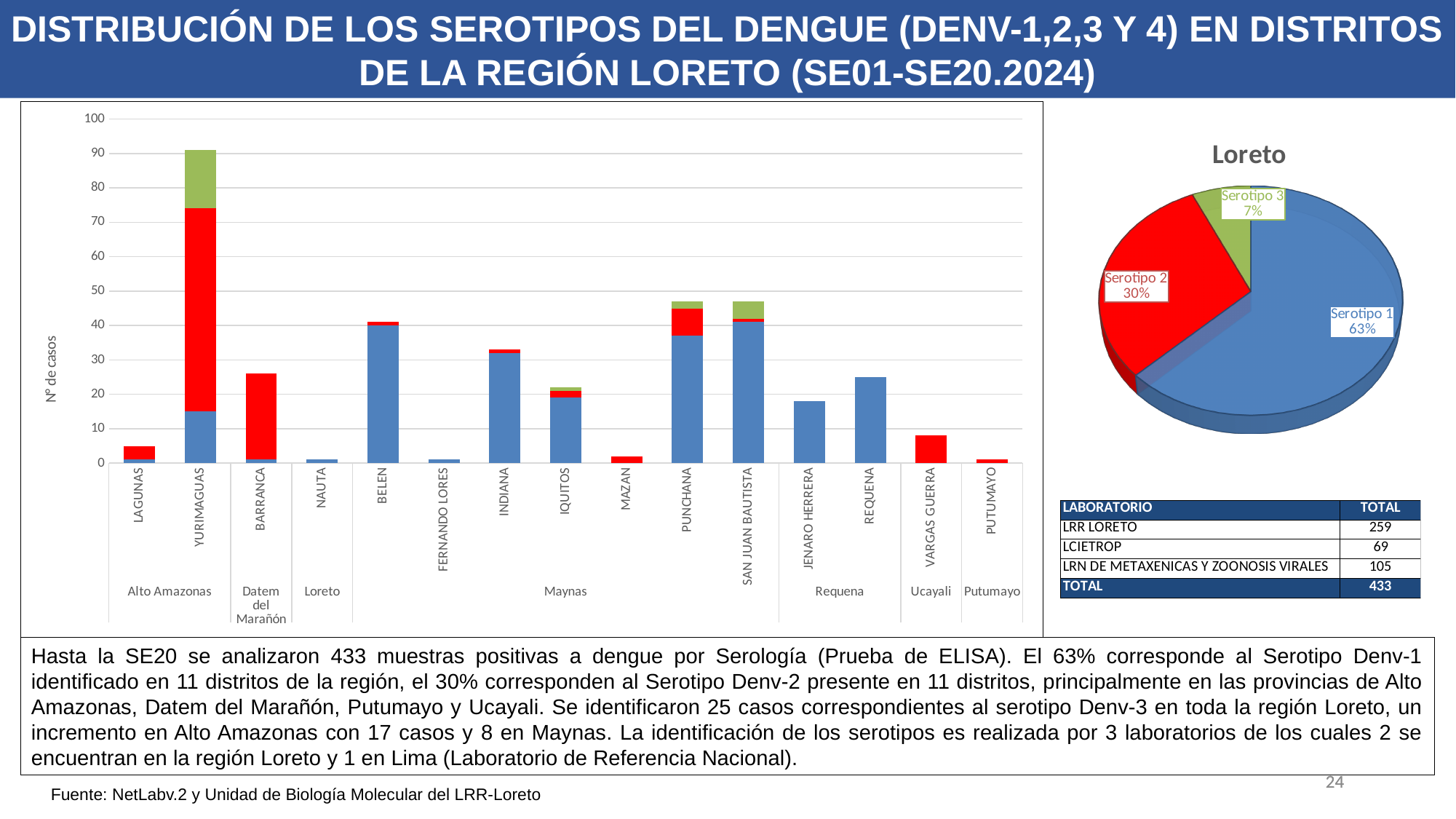
In the pie chart titled Loreto, how many percentage points larger is the Serotipo 1 share than the Serotipo 2 share? 33 In the bar chart on the left, which district has the highest total number of cases? YURIMAGUAS In the bar chart on the left, is the total value for YURIMAGUAS greater or less than 80? greater In the bar chart on the left, which has more cases, REQUENA or JENARO HERRERA? REQUENA In the bar chart on the left, is the total value for BARRANCA greater or less than 30? less In the pie chart titled Loreto, what percentage corresponds to Serotipo 3? 7% In the pie chart titled Loreto, what percentage corresponds to Serotipo 2? 30% In the pie chart titled Loreto, which serotype has the smallest share? Serotipo 3 What kind of chart is the chart on the right side of the slide? Pie chart In the pie chart titled Loreto, how many slices are there? 3 In the pie chart titled Loreto, what percentage corresponds to Serotipo 1? 63% In the pie chart titled Loreto, which serotype has the largest share? Serotipo 1